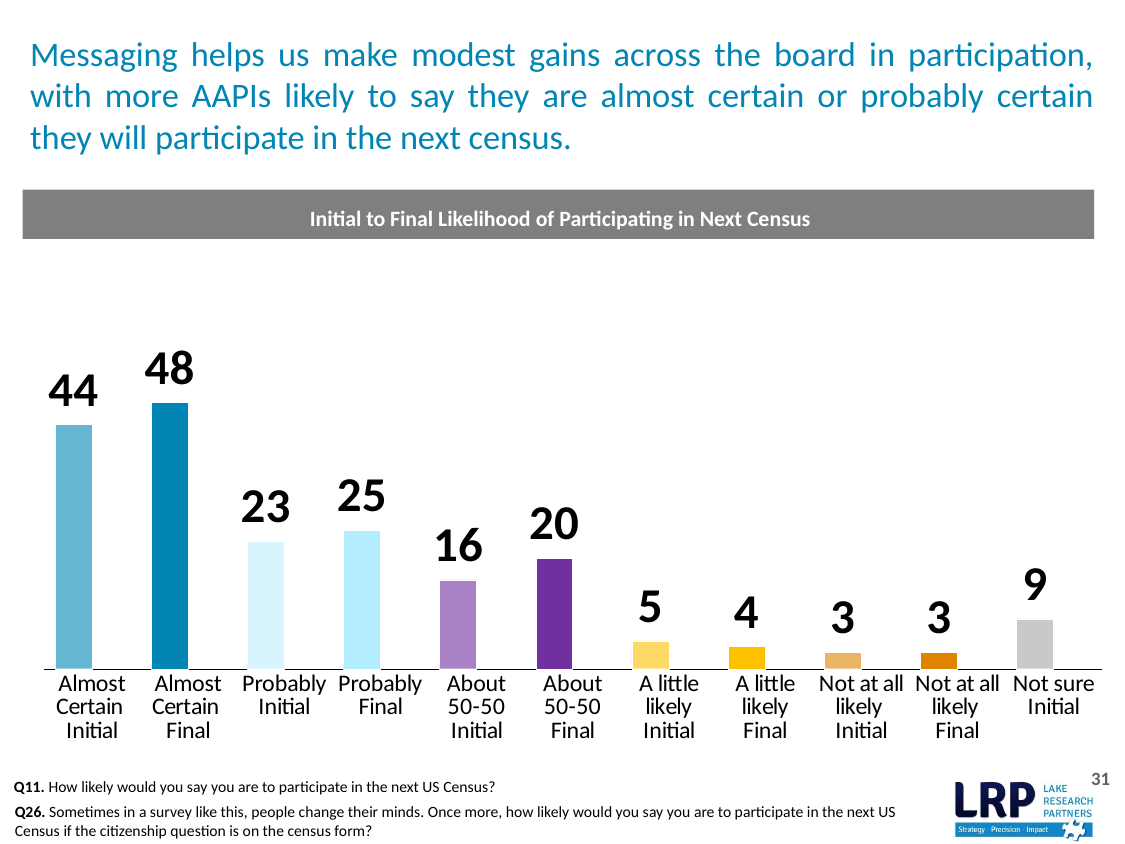
How many bars are shown in the chart? 11 What is the difference between About 50-50 Final and About 50-50 Initial? 4 Which is larger, Probably Final or Probably Initial? Probably Final What kind of chart is shown on the slide? Bar chart What is the value for Not at all likely Final? 3 What is the value for Almost Certain Final? 48 What is the value for Not sure Initial? 9 Which is larger, A little likely Initial or A little likely Final? A little likely Initial What is the title of the chart? Initial to Final Likelihood of Participating in Next Census Which category has the highest value? Almost Certain Final What is the difference between Almost Certain Final and Almost Certain Initial? 4 What is the value for About 50-50 Initial? 16